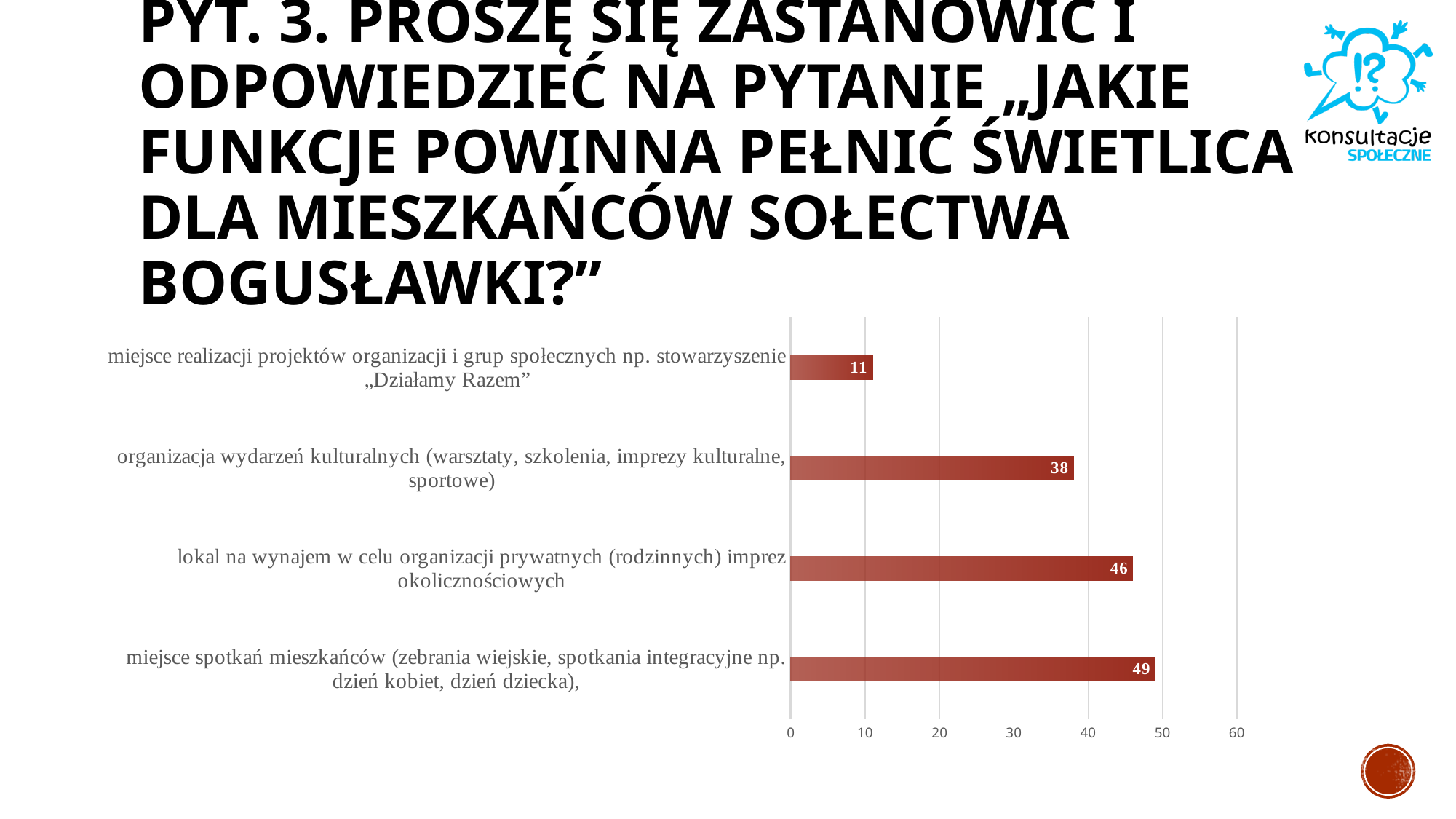
Which category has the highest value? miejsce spotkań mieszkańców (zebrania wiejskie, spotkania integracyjne np. dzień kobiet, dzień dziecka), Which category has the lowest value? miejsce realizacji projektów organizacji i grup społecznych np. stowarzyszenie „Działamy Razem” What is the difference between the highest and lowest values in the chart? 38 What is the value for "organizacja wydarzeń kulturalnych (warsztaty, szkolenia, imprezy kulturalne, sportowe)"? 38 What is the difference between the value for "lokal na wynajem w celu organizacji prywatnych (rodzinnych) imprez okolicznościowych" and the value for "organizacja wydarzeń kulturalnych (warsztaty, szkolenia, imprezy kulturalne, sportowe)"? 8 How many categories are shown in the chart? 4 What is the value for "miejsce realizacji projektów organizacji i grup społecznych np. stowarzyszenie „Działamy Razem”"? 11 What is the value for "miejsce spotkań mieszkańców (zebrania wiejskie, spotkania integracyjne np. dzień kobiet, dzień dziecka),"? 49 Is the value for "organizacja wydarzeń kulturalnych (warsztaty, szkolenia, imprezy kulturalne, sportowe)" greater or less than 40? less Which is larger: the value for "organizacja wydarzeń kulturalnych (warsztaty, szkolenia, imprezy kulturalne, sportowe)" or the value for "miejsce realizacji projektów organizacji i grup społecznych np. stowarzyszenie „Działamy Razem”"? organizacja wydarzeń kulturalnych (warsztaty, szkolenia, imprezy kulturalne, sportowe) What is the value for "lokal na wynajem w celu organizacji prywatnych (rodzinnych) imprez okolicznościowych"? 46 What kind of chart is shown on the slide? bar chart